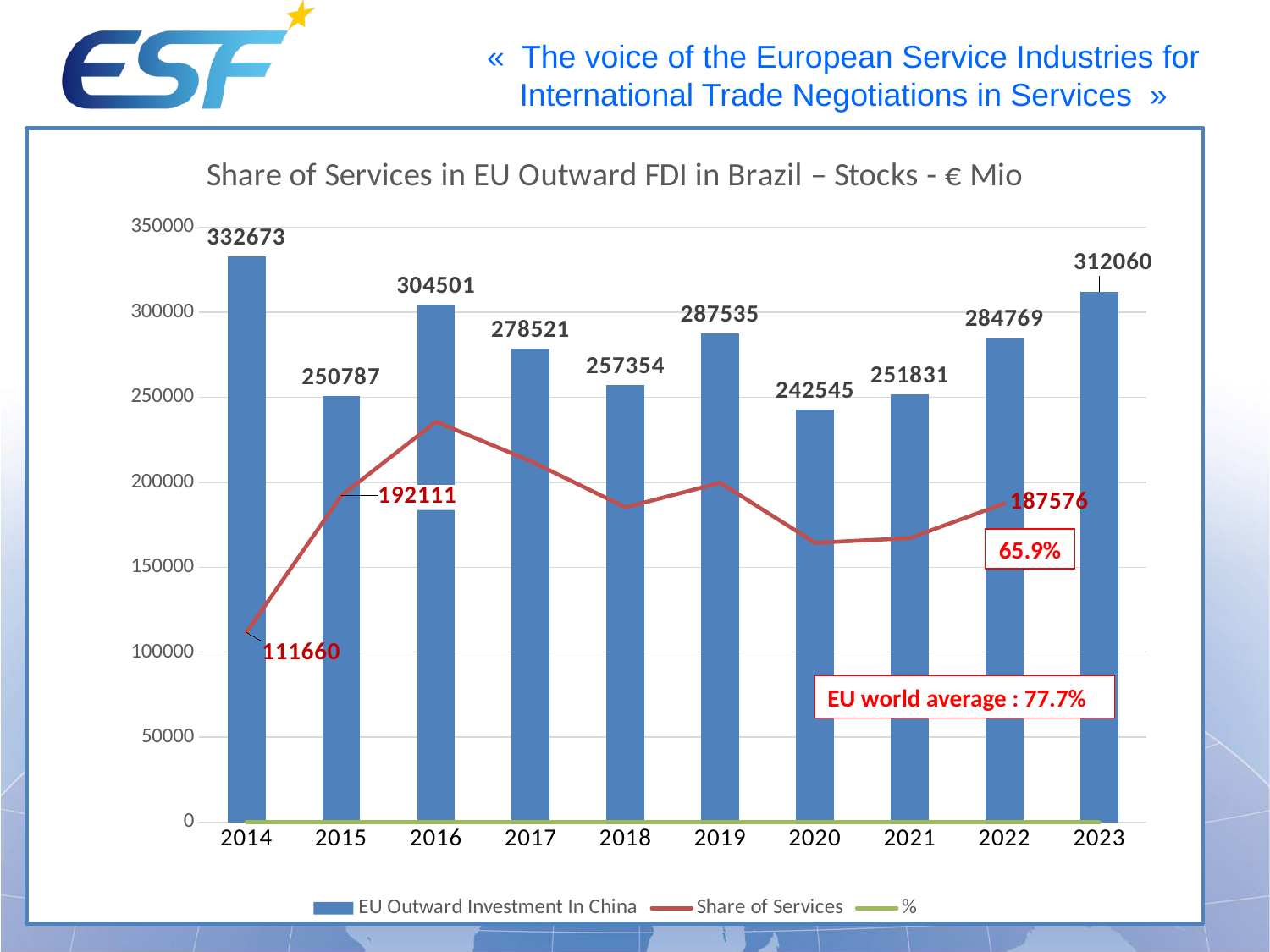
What is the Share of Services value labelled for 2015? 192111 How many series does the legend list? 3 What is the value of the EU Outward Investment bar for 2014? 332673 How many years are shown on the x axis? 10 What is the Share of Services value labelled for 2022? 187576 Which year has the lowest EU Outward Investment bar? 2020 Is the Share of Services value for 2016 greater or less than 200000? greater What is the value of the EU Outward Investment bar for 2023? 312060 Which year has the larger EU Outward Investment bar, 2016 or 2019? 2016 What is the difference between the EU Outward Investment bars for 2014 and 2023? 20613 What EU world average percentage is shown in the text box on the chart? 77.7% Which year has the highest EU Outward Investment bar? 2014